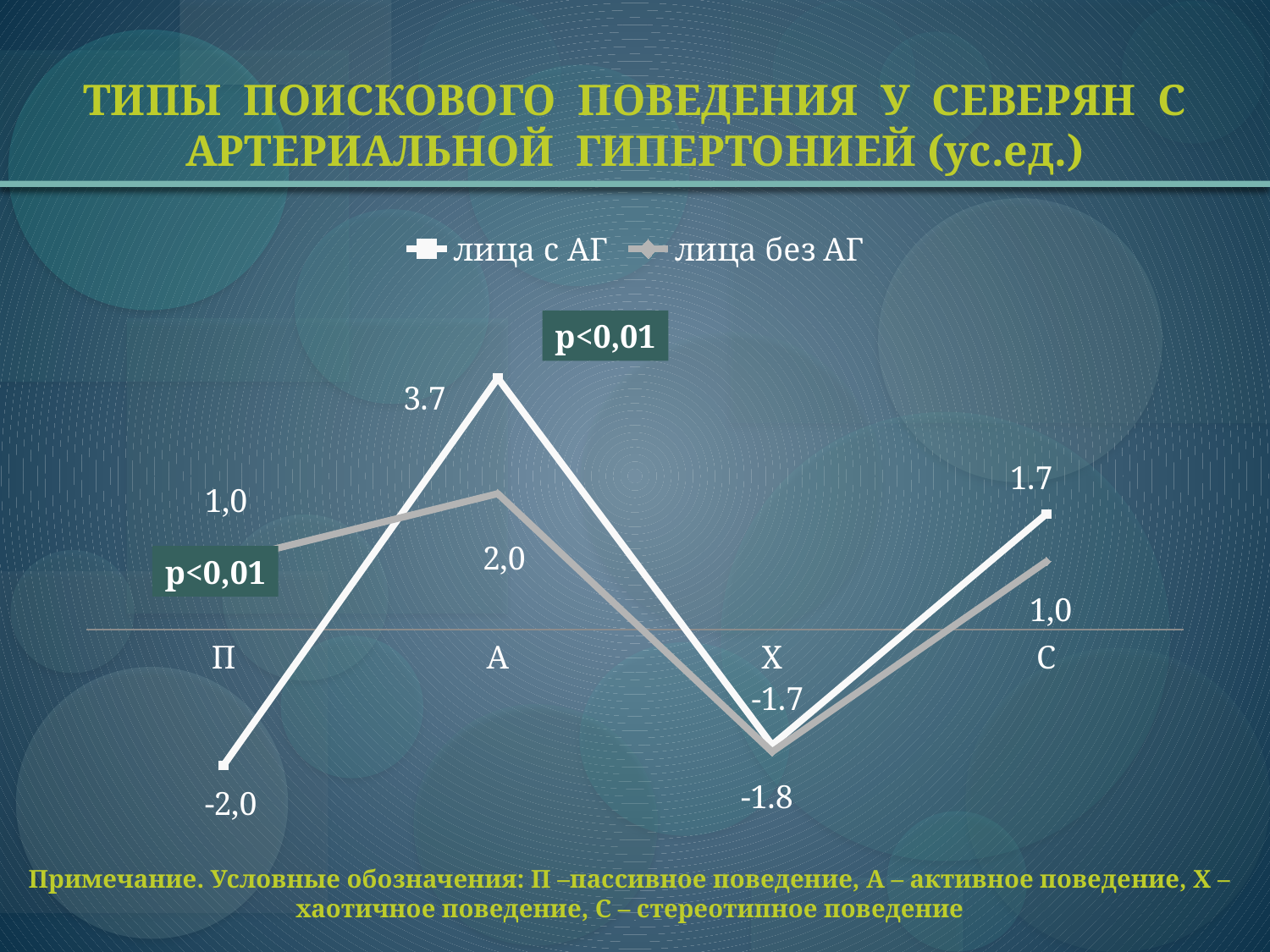
What is the value for лица с АГ at category П? -2,0 For the series лица с АГ, which category has the lowest value? П What kind of chart is shown on the slide? line chart What is the value for лица с АГ at category С? 1.7 How many categories are plotted along the x axis? 4 At category П, which series has the larger value, лица с АГ or лица без АГ? лица без АГ How many series does the legend list? 2 What is the value for лица без АГ at category С? 1,0 What is the value for лица без АГ at category П? 1,0 What is the value for лица с АГ at category А? 3.7 What is the value for лица без АГ at category А? 2,0 For the series лица с АГ, which category has the highest value? А